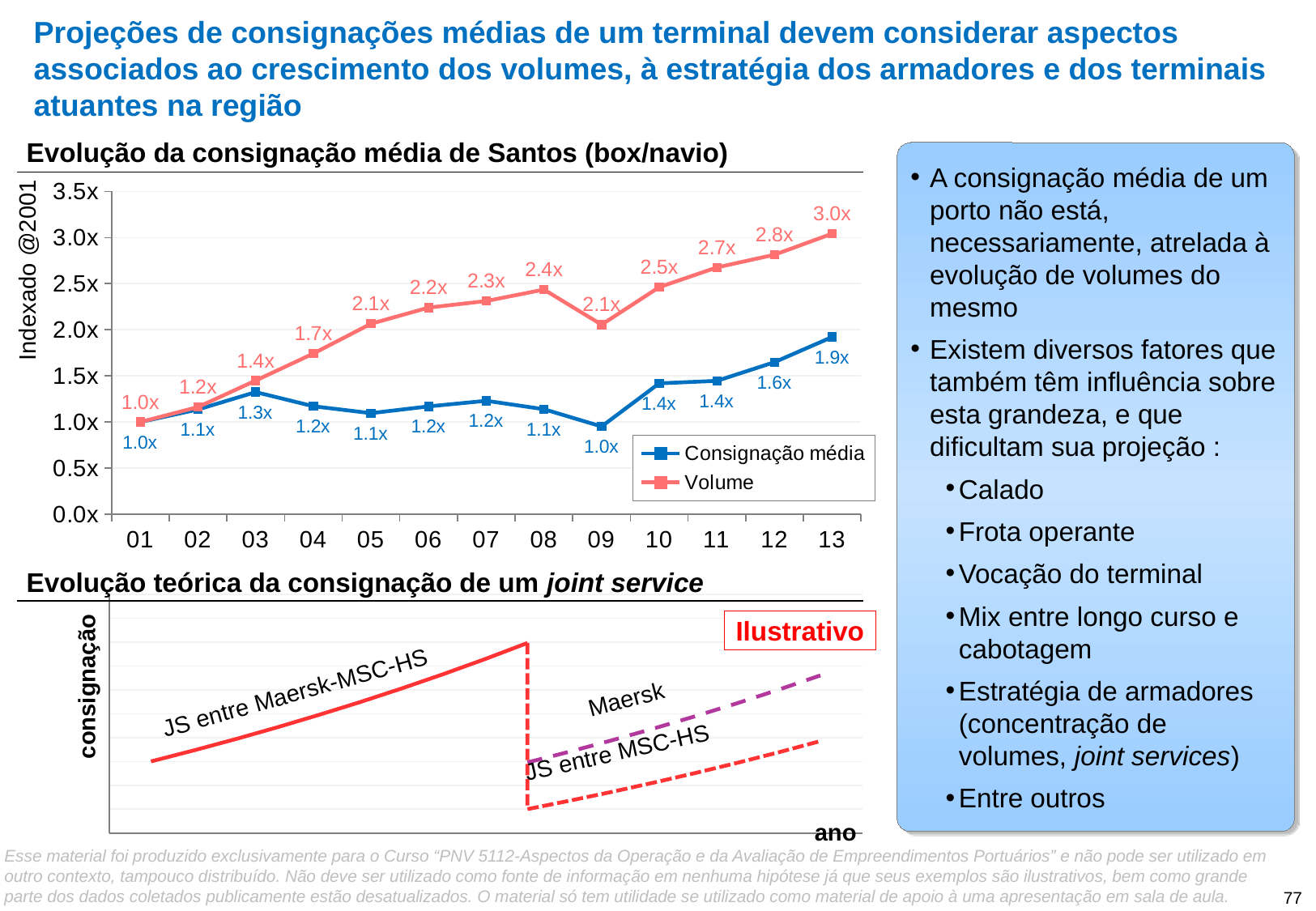
In the chart 'Evolução da consignação média de Santos (box/navio)', what is the Consignação média value for year 09? 1.0x How many series does the legend of the chart 'Evolução da consignação média de Santos (box/navio)' list? 2 How many years are shown on the x axis of the chart 'Evolução da consignação média de Santos (box/navio)'? 13 In the chart 'Evolução da consignação média de Santos (box/navio)', what is the Volume value for year 13? 3.0x In the chart 'Evolução da consignação média de Santos (box/navio)', what is the Volume value for year 04? 1.7x In the chart 'Evolução da consignação média de Santos (box/navio)', what is the difference between Volume and Consignação média in year 13? 1.1x In the chart 'Evolução da consignação média de Santos (box/navio)', which series has the larger value in year 09, Volume or Consignação média? Volume In the chart 'Evolução da consignação média de Santos (box/navio)', does the Volume series rise or fall from year 01 to year 08? Rise In the chart 'Evolução da consignação média de Santos (box/navio)', in which year is the Volume series highest? 13 In the chart 'Evolução da consignação média de Santos (box/navio)', is the Consignação média value for year 13 greater or less than 1.5x? greater What kind of chart is 'Evolução da consignação média de Santos (box/navio)'? Line chart In the chart 'Evolução da consignação média de Santos (box/navio)', in which year does the Consignação média series reach its highest value? 13